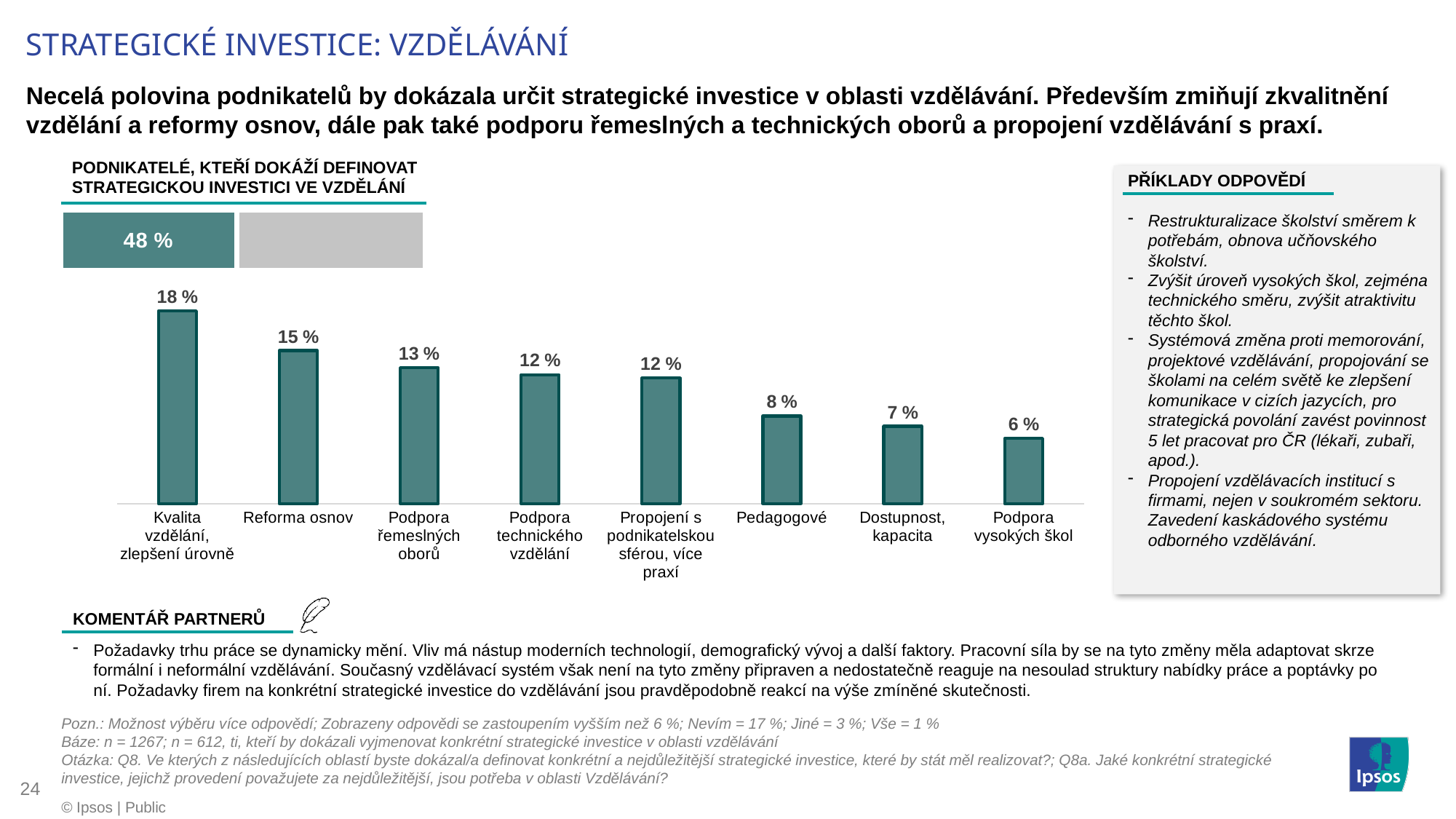
What kind of chart is used to show the categories from Kvalita vzdělání to Podpora vysokých škol? bar chart What is the value for Kvalita vzdělání, zlepšení úrovně in the bar chart? 18 % Which is larger: the value for Podpora řemeslných oborů or the value for Dostupnost, kapacita? Podpora řemeslných oborů Which category has the lowest value in the bar chart? Podpora vysokých škol What share of entrepreneurs can define a strategic investment in education, according to the bar above the chart? 48 % Do the values in the bar chart rise or fall from left to right? fall What is the value for Reforma osnov in the bar chart? 15 % What is the difference between the values for Kvalita vzdělání, zlepšení úrovně and Reforma osnov? 3 % Which category has the highest value in the bar chart? Kvalita vzdělání, zlepšení úrovně What is the value for Podpora vysokých škol in the bar chart? 6 % What is the value for Pedagogové in the bar chart? 8 % How many categories are shown in the bar chart? 8